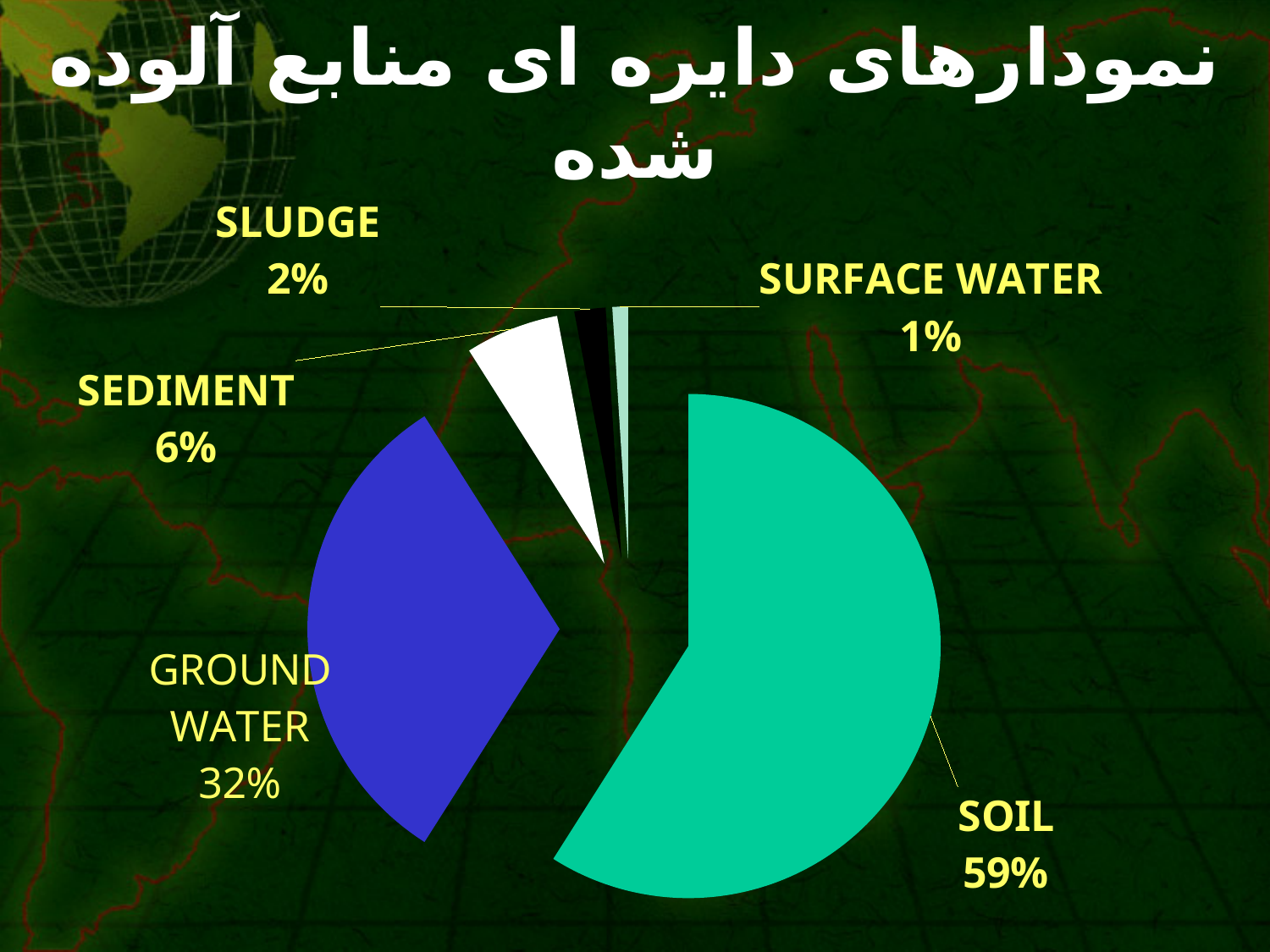
Which category has the smallest slice of the pie? SURFACE WATER What percentage is shown for SLUDGE? 2% What share of the pie does SOIL account for? 59% What percentage is shown for SURFACE WATER? 1% What colour is the SOIL slice of the pie? green How many categories are shown in the pie chart? 5 Which category has the largest slice of the pie? SOIL What is the difference in percentage points between SOIL and GROUND WATER? 27 What percentage is shown for GROUND WATER? 32% What kind of chart is shown on the slide? pie chart What percentage is shown for SEDIMENT? 6% Which is larger, the share for SEDIMENT or the share for SLUDGE? SEDIMENT